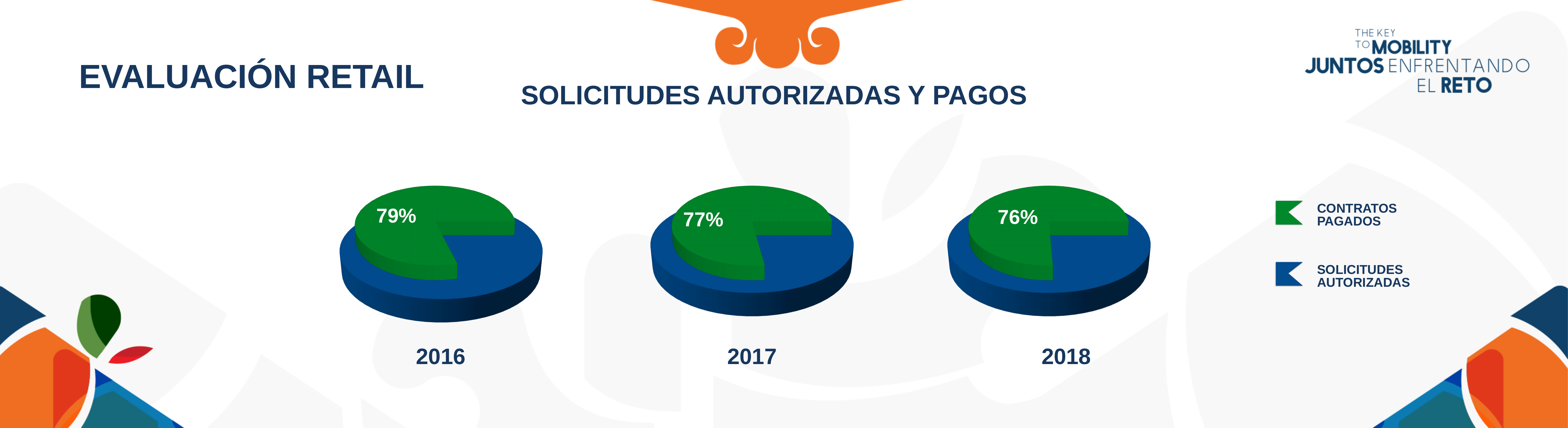
Which legend entry is represented by the green colour in the pie charts? CONTRATOS PAGADOS Across the three pie charts, which year has the lowest Contratos Pagados percentage? 2018 Which year shows a larger Contratos Pagados percentage, 2017 or 2018? 2017 What kind of charts are shown under the title 'SOLICITUDES AUTORIZADAS Y PAGOS'? Pie charts How many pie charts are shown on the slide? 3 In the 2017 pie chart, what percentage is shown for Contratos Pagados? 77% In the 2018 pie chart, what percentage is shown for Contratos Pagados? 76% What is the difference in percentage points between the Contratos Pagados share in 2016 and in 2018? 3 percentage points How many entries does the legend list? 2 Across the three pie charts, which year has the highest Contratos Pagados percentage? 2016 Does the Contratos Pagados percentage rise or fall from 2016 to 2018? Fall In the 2016 pie chart, what percentage is shown for Contratos Pagados? 79%